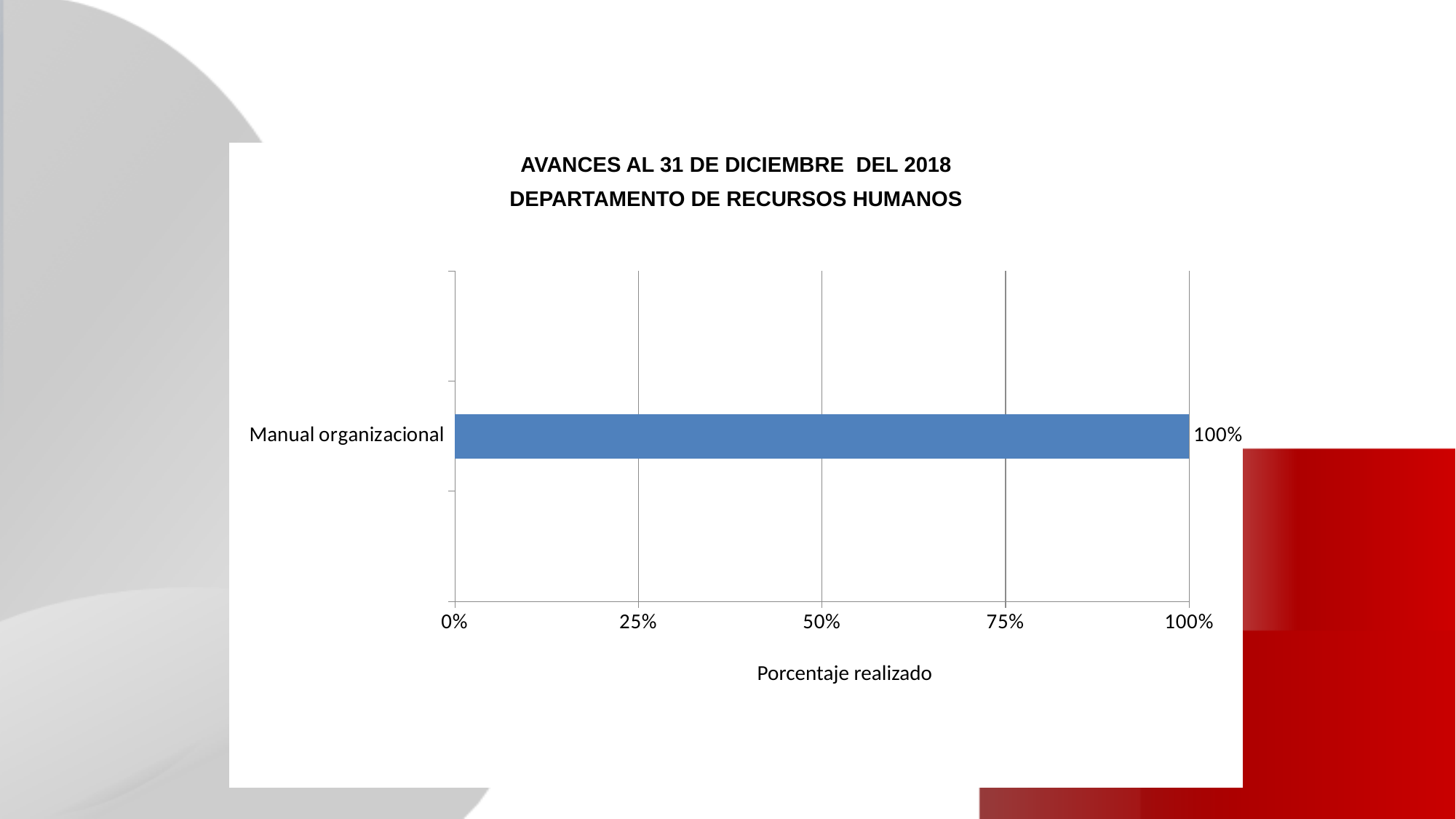
What is the value for Manual organizacional? 100% What is the label of the horizontal axis? Porcentaje realizado How many categories are plotted in the chart? 1 What is the maximum value shown on the horizontal axis? 100% Which category has the highest value in the chart? Manual organizacional What kind of chart is shown on the slide? bar chart Is the value for Manual organizacional greater or less than 75%? greater What is the title of the chart? AVANCES AL 31 DE DICIEMBRE DEL 2018 DEPARTAMENTO DE RECURSOS HUMANOS